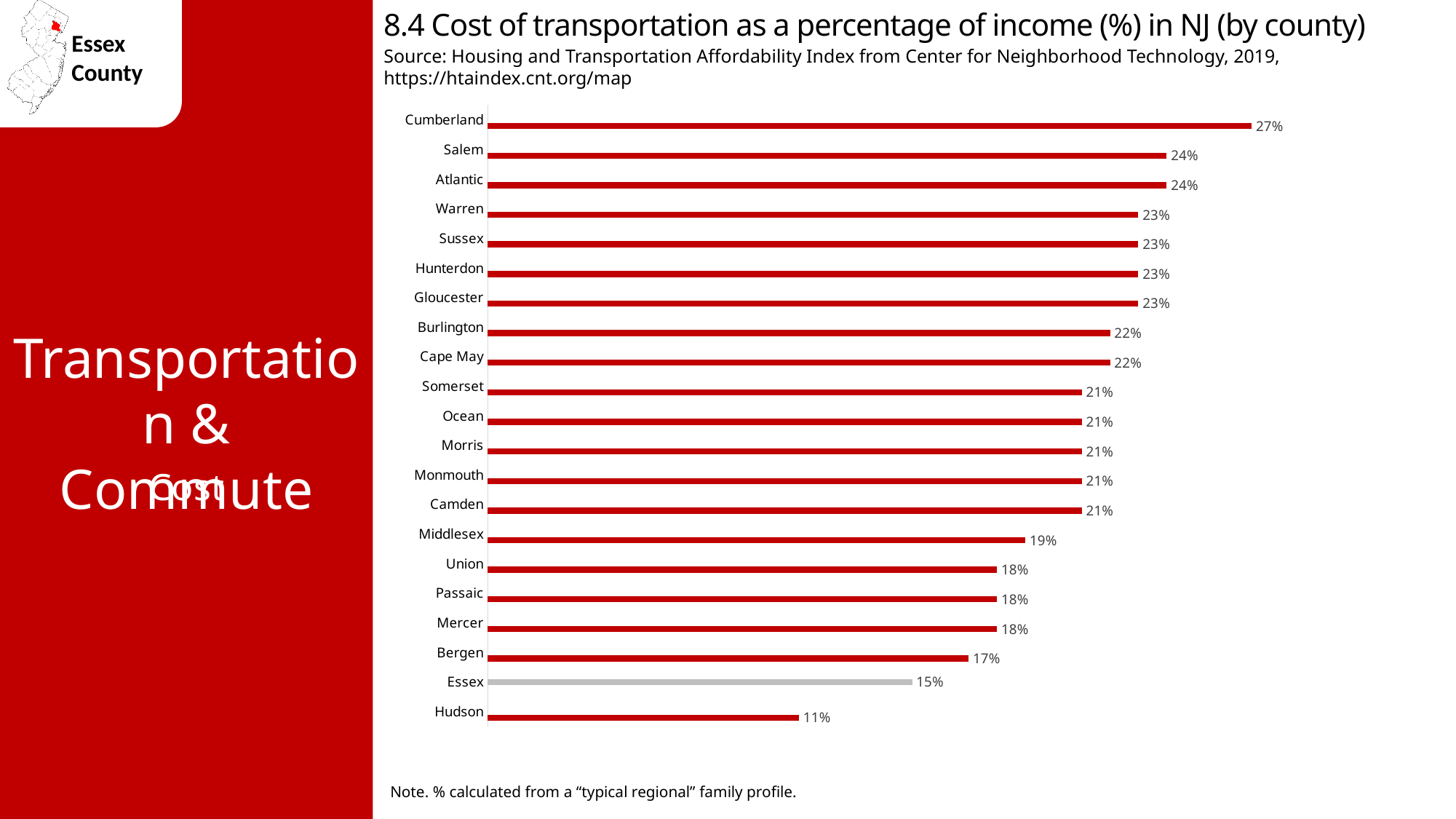
What is the value shown for Hudson County? 11% Which county has the lowest cost of transportation as a percentage of income? Hudson What is the value shown for Bergen County? 17% What type of chart is shown on the slide? Bar chart What is the cost of transportation as a percentage of income for Essex County? 15% Which county has the highest cost of transportation as a percentage of income? Cumberland What is the value shown for Cumberland County? 27% What is the difference in percentage points between Cumberland and Essex? 12 How many counties are shown in the chart? 21 Which county has a larger value, Middlesex or Bergen? Middlesex Which county's bar is shown in a different colour (grey) from the others? Essex What is the difference in percentage points between Essex and Hudson? 4